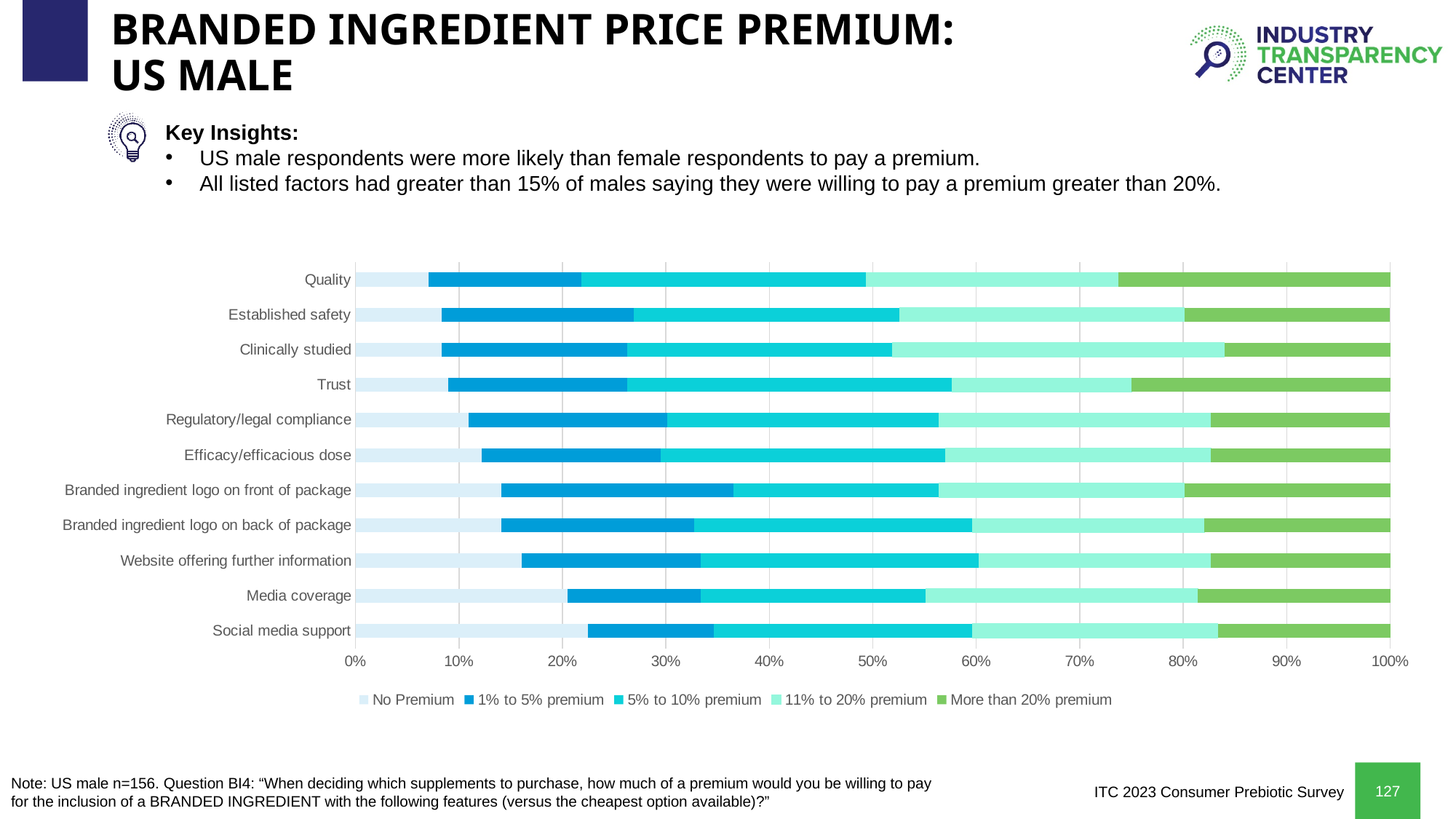
Which category has the largest 'No Premium' segment? Social media support Is the 'No Premium' share for Website offering further information greater or less than 10%? greater Is the 'No Premium' share for Social media support greater or less than 20%? greater Is the 'No Premium' share for Quality greater or less than 10%? less What colour represents the 'More than 20% premium' series? Green How many series does the chart legend list? 5 What is the first entry in the chart legend? No Premium Which has the larger 'No Premium' segment: Social media support or Quality? Social media support Which has the larger '1% to 5% premium' segment: Branded ingredient logo on front of package or Quality? Branded ingredient logo on front of package How many categories (factors) are listed on the chart's vertical axis? 11 Moving down the chart from Quality to Social media support, does the 'No Premium' segment generally get larger or smaller? larger What kind of chart is shown on the slide? Stacked bar chart